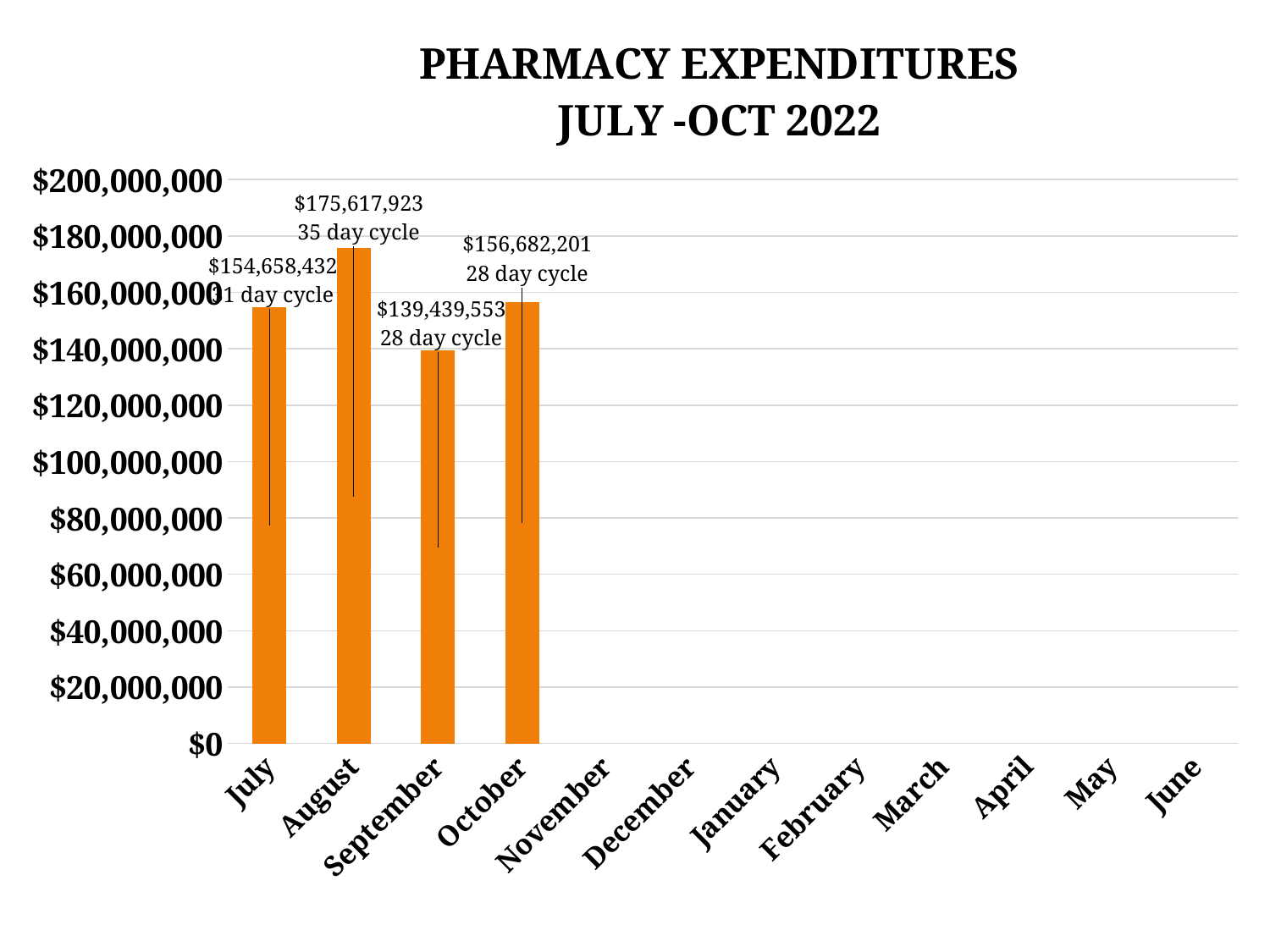
What kind of chart is shown on the slide? Bar chart Which month has the lowest pharmacy expenditure among the plotted months? September Which month has the highest pharmacy expenditure? August What is the pharmacy expenditure for October? $156,682,201 What is the pharmacy expenditure for August? $175,617,923 What is the title of the chart? PHARMACY EXPENDITURES JULY -OCT 2022 How many days is the billing cycle noted for August? 35 day cycle What is the pharmacy expenditure for July? $154,658,432 How many months have a bar plotted on the chart? 4 Is the expenditure for September greater or less than $140,000,000? less What is the difference between the August and September expenditures? $36,178,370 What is the pharmacy expenditure for September? $139,439,553